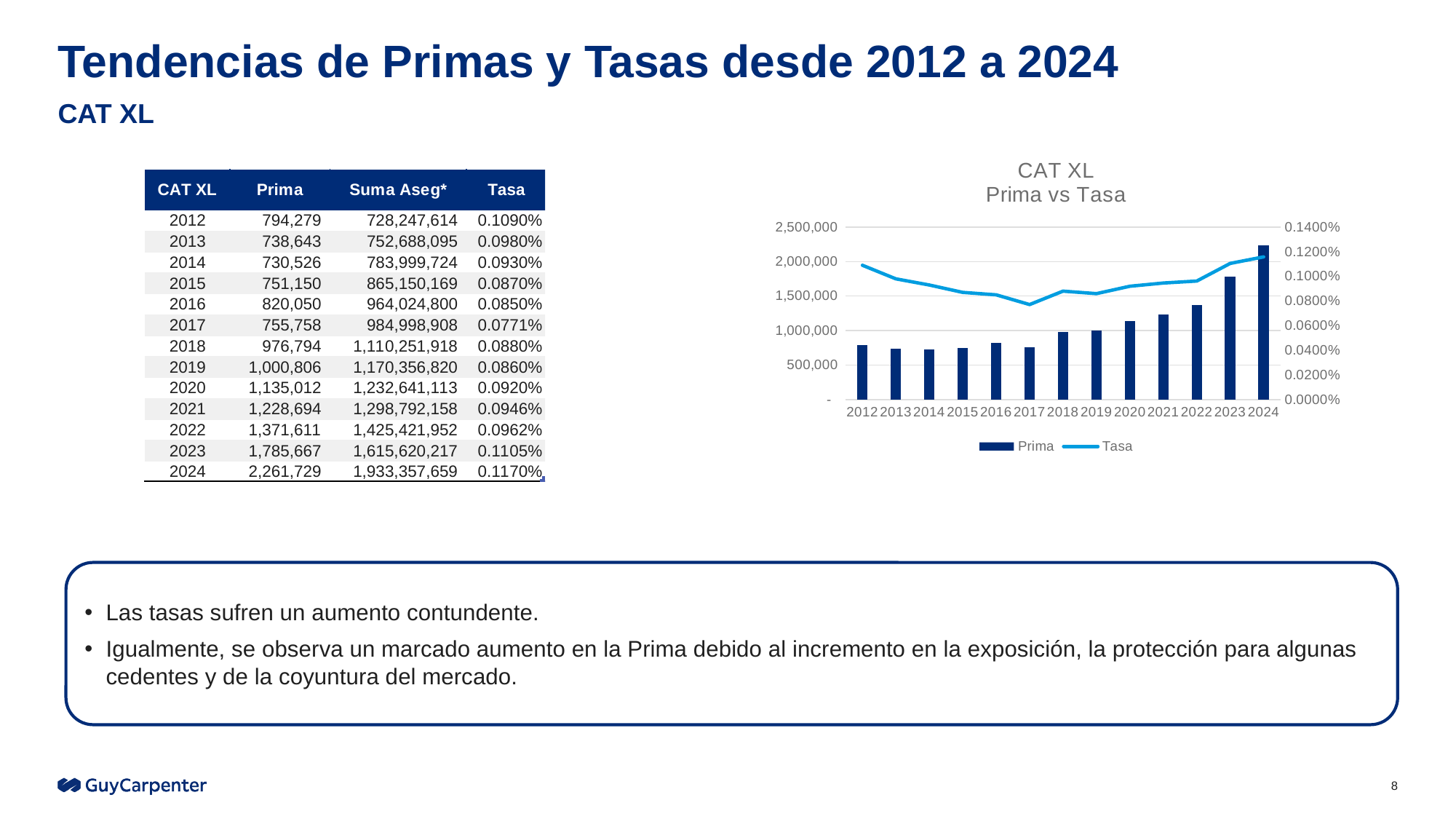
In the "CAT XL Prima vs Tasa" chart, which year has the highest Prima? 2024 In the "CAT XL Prima vs Tasa" chart, which year has the highest Tasa? 2024 How many years are shown on the x axis of the "CAT XL Prima vs Tasa" chart? 13 In the "CAT XL Prima vs Tasa" chart, which year has the lowest Tasa? 2017 What kind of chart is the "CAT XL Prima vs Tasa" chart? A combined bar and line chart What is the Tasa value for 2012 shown on the slide? 0.1090% In the "CAT XL Prima vs Tasa" chart, which is larger, the Prima for 2022 or the Prima for 2018? 2022 How many series does the legend of the "CAT XL Prima vs Tasa" chart list? 2 In the "CAT XL Prima vs Tasa" chart, is the Prima value for 2012 greater or less than 1,000,000? less What is the Prima value for 2024 shown on the slide? 2,261,729 In the "CAT XL Prima vs Tasa" chart, does the Tasa line rise or fall from 2012 to 2017? fall In the "CAT XL Prima vs Tasa" chart, is the Prima value for 2024 greater or less than 2,000,000? greater